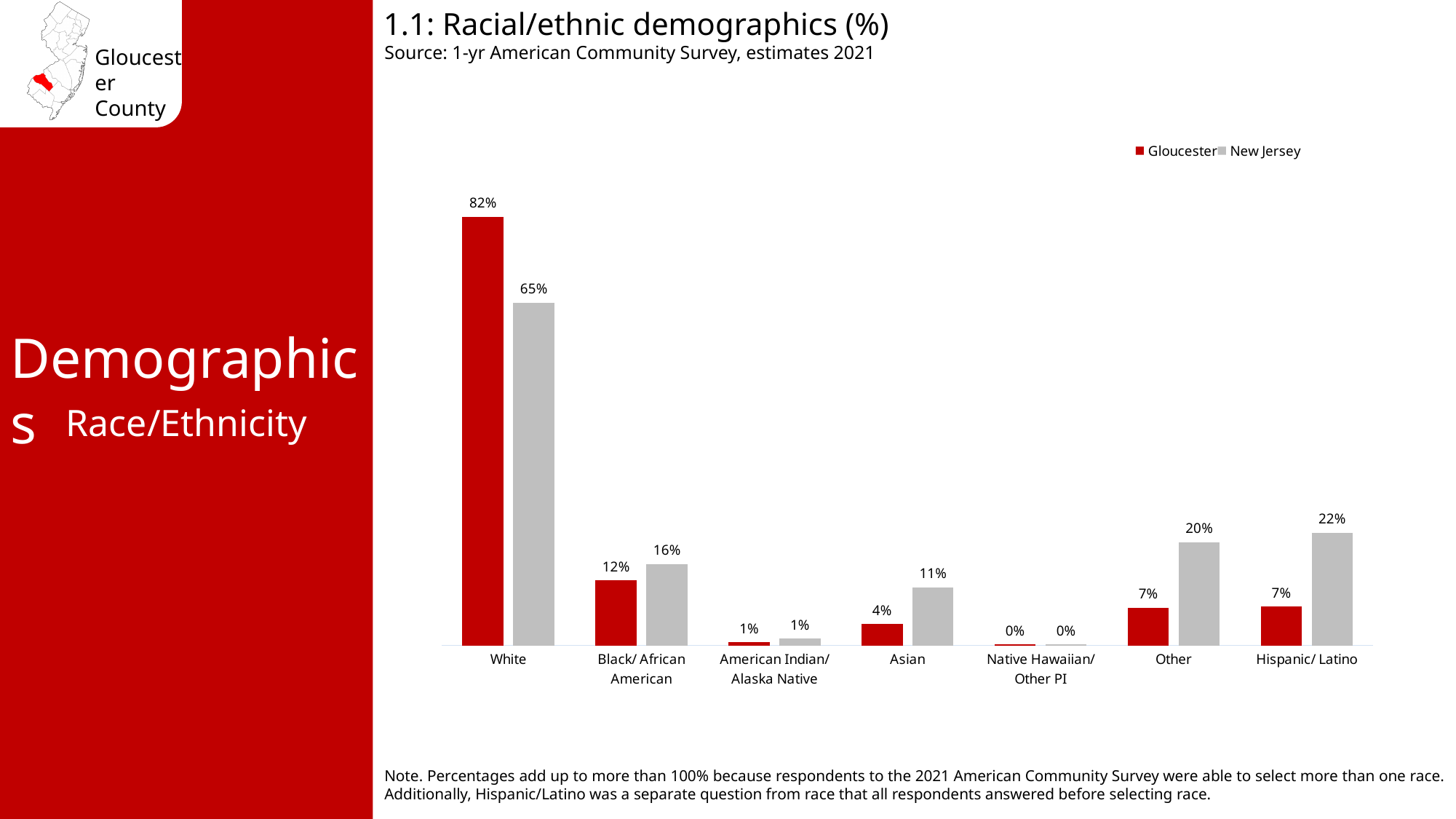
What is the difference between the New Jersey and Gloucester values for Other? 13% Which category has the lowest New Jersey value? Native Hawaiian/ Other PI Which category has the highest Gloucester value? White What is the New Jersey value for Asian? 11% What is the difference between the Gloucester and New Jersey values for White? 17% What is the Gloucester value for Black/ African American? 12% How many categories are shown on the x axis? 7 What kind of chart is shown on the slide? Bar chart What is the New Jersey value for Hispanic/ Latino? 22% Which is larger for Asian, the Gloucester value or the New Jersey value? New Jersey How many series does the legend list? 2 What is the Gloucester value for White? 82%